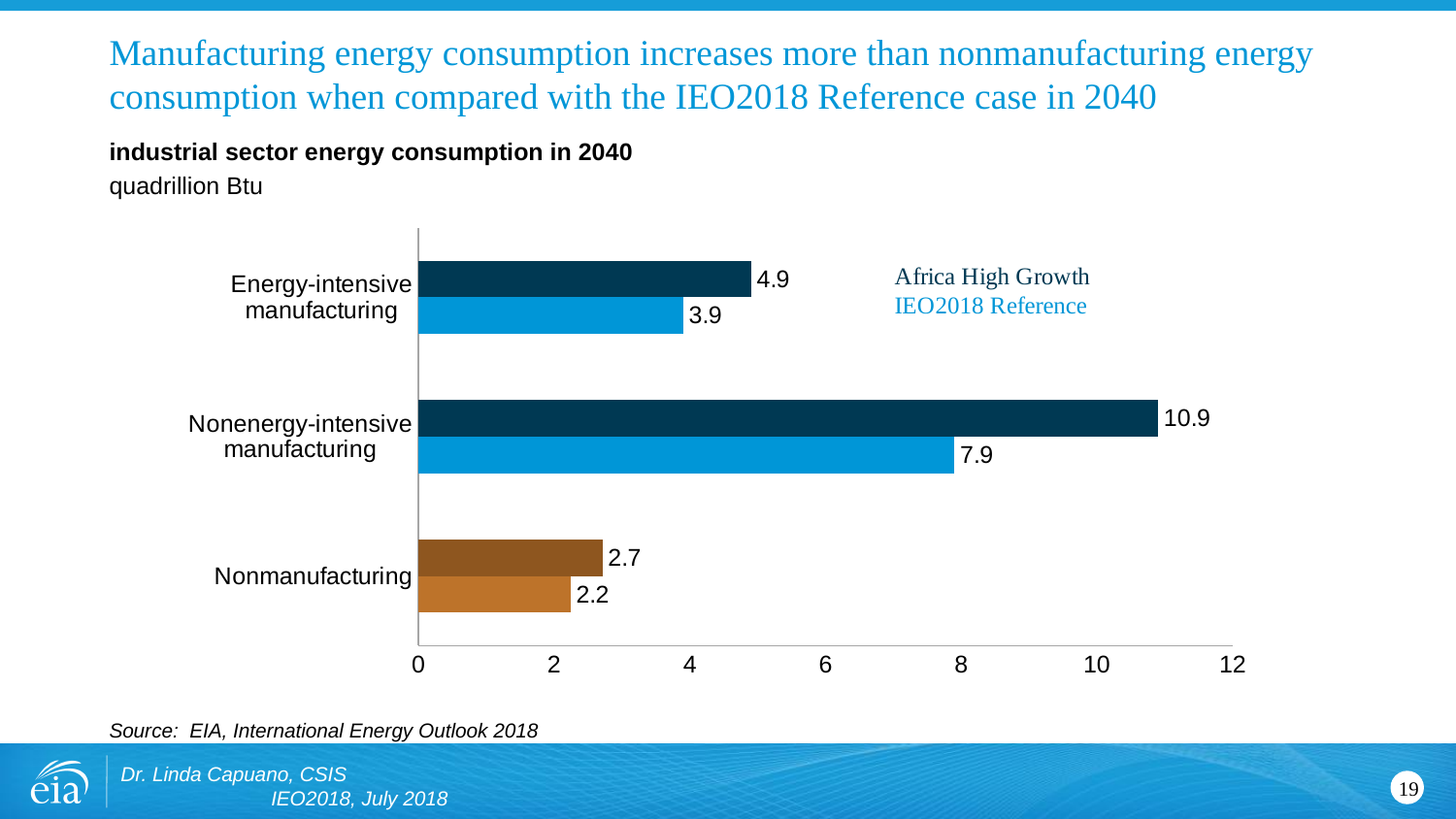
What is the IEO2018 Reference value for Nonenergy-intensive manufacturing? 7.9 What is the Africa High Growth value for Energy-intensive manufacturing? 4.9 What is the difference between the Africa High Growth and IEO2018 Reference values for Energy-intensive manufacturing? 1.0 Which is larger for Nonmanufacturing: the Africa High Growth value or the IEO2018 Reference value? Africa High Growth How many categories are shown on the chart? 3 What kind of chart is shown on the slide? bar chart What is the difference between the Africa High Growth and IEO2018 Reference values for Nonenergy-intensive manufacturing? 3.0 Which category has the lowest IEO2018 Reference value? Nonmanufacturing Which category has the highest Africa High Growth value? Nonenergy-intensive manufacturing Is the Africa High Growth value for Nonenergy-intensive manufacturing greater or less than 10? greater How many series does the legend list? 2 What is the IEO2018 Reference value for Nonmanufacturing? 2.2